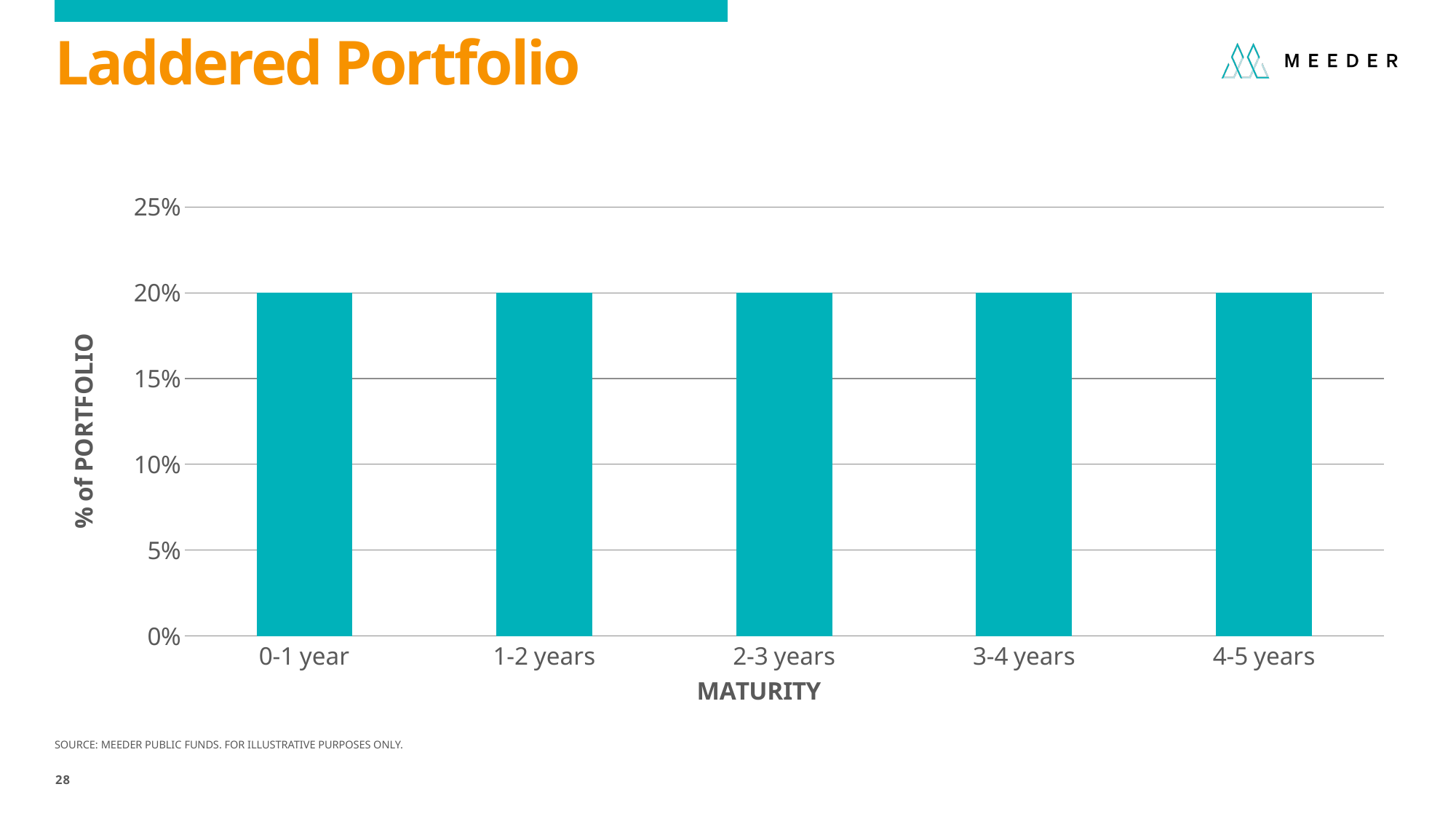
What kind of chart is shown on the slide? Bar chart What is the label of the y axis? % of PORTFOLIO What is the % of portfolio for the 4-5 years maturity? 20% What is the % of portfolio for the 0-1 year maturity? 20% What is the title of the slide containing the chart? Laddered Portfolio Do the values rise, fall, or stay the same across the maturity categories from left to right? Stay the same What is the % of portfolio for the 2-3 years maturity? 20% What is the label of the x axis? MATURITY How many maturity categories are shown on the x axis? 5 Is the value for 3-4 years greater or less than 25%? less Is the value for 1-2 years greater or less than 15%? greater What is the difference between the values for 0-1 year and 4-5 years? 0%